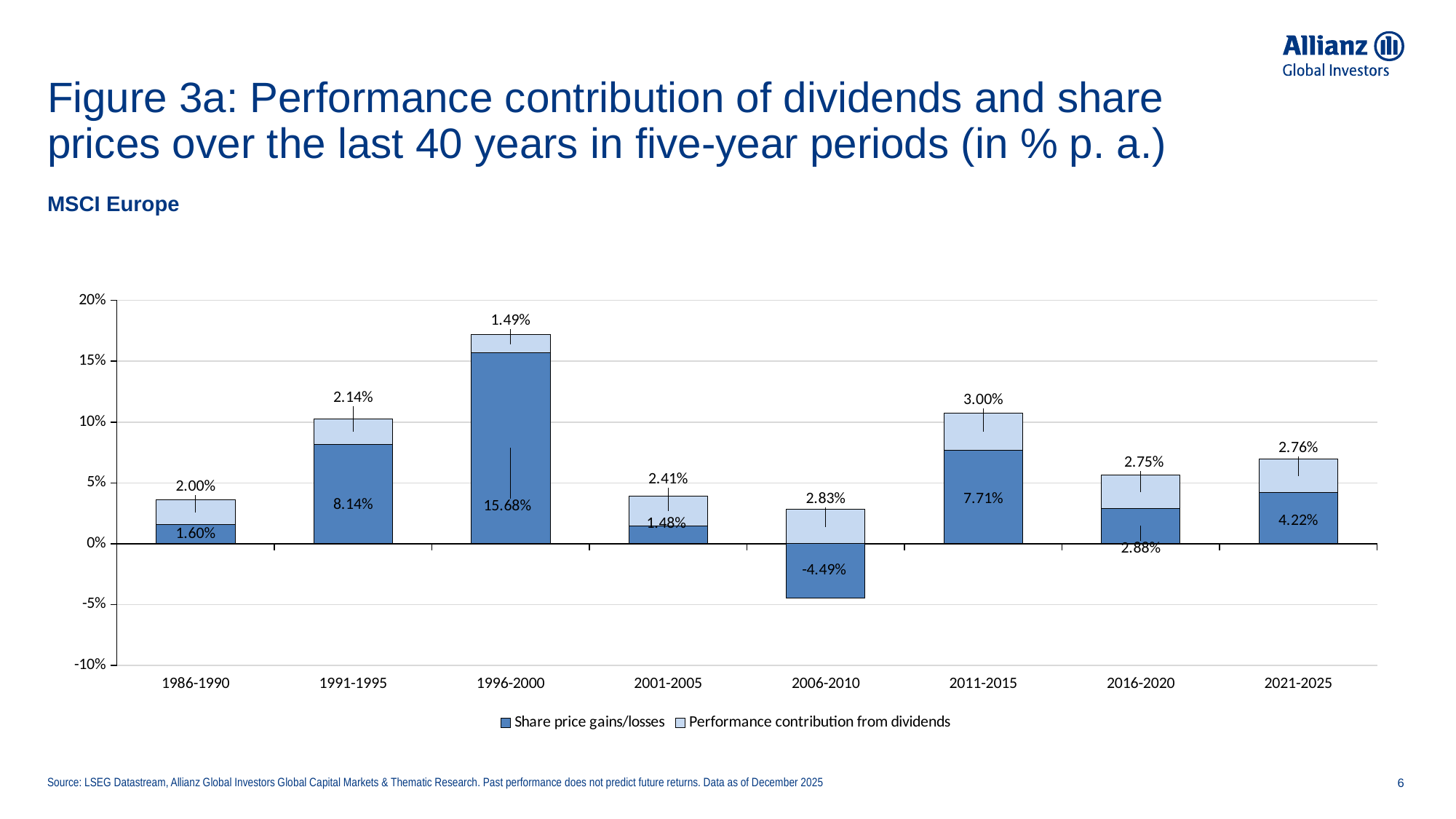
How many five-year periods are shown on the x axis? 8 Is the total height of the stacked bar for 1991-1995 greater or less than 10%? greater Which is larger: the performance contribution from dividends in 2016-2020 or in 2021-2025? 2021-2025 What is the total of the stacked bar for 2021-2025 (share price gains plus dividend contribution)? 6.98% What is the performance contribution from dividends for 2011-2015? 3.00% What kind of chart is shown on the slide? Stacked bar chart What is the share price gains/losses value for 1996-2000? 15.68% Which period has the lowest performance contribution from dividends? 1996-2000 How many series does the legend list? 2 What is the difference between the share price gains/losses for 1991-1995 and 2011-2015? 0.43% Which period has the highest share price gains/losses value? 1996-2000 What is the share price gains/losses value for 2006-2010? -4.49%